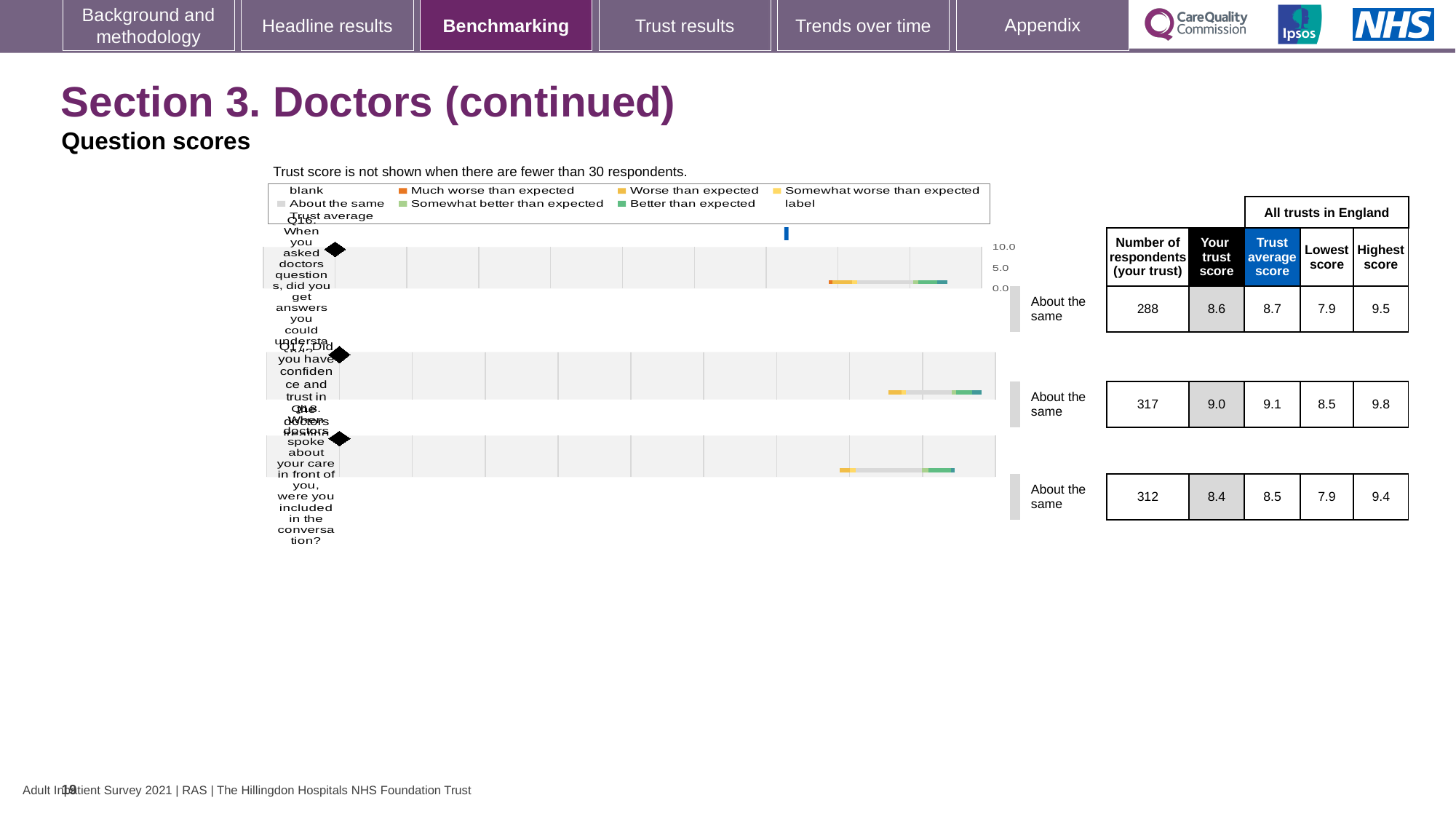
Which of the three questions shown has the lowest 'Your trust score'? Q18 For Q17, what is the difference between the highest score and the lowest score across all trusts in England? 1.3 For Q16 (when you asked doctors questions, did you get answers you could understand), how many respondents did the trust have? 288 What is the trust's score for Q16 (when you asked doctors questions, did you get answers you could understand)? 8.6 What is the lowest score across all trusts in England for Q16? 7.9 Is the trust's score for Q18 greater or less than 5.0? greater What is the highest score across all trusts in England for Q18 (when doctors spoke about your care in front of you, were you included in the conversation)? 9.4 How many questions are charted on this slide? 3 For Q16, which is larger: the trust's own score or the trust average score? Trust average score Which of the three questions shown has the highest 'Your trust score'? Q17 What benchmark category is shown for Q17 (did you have confidence and trust in the doctors treating you)? About the same What is the trust average score for Q17 (did you have confidence and trust in the doctors treating you)? 9.1